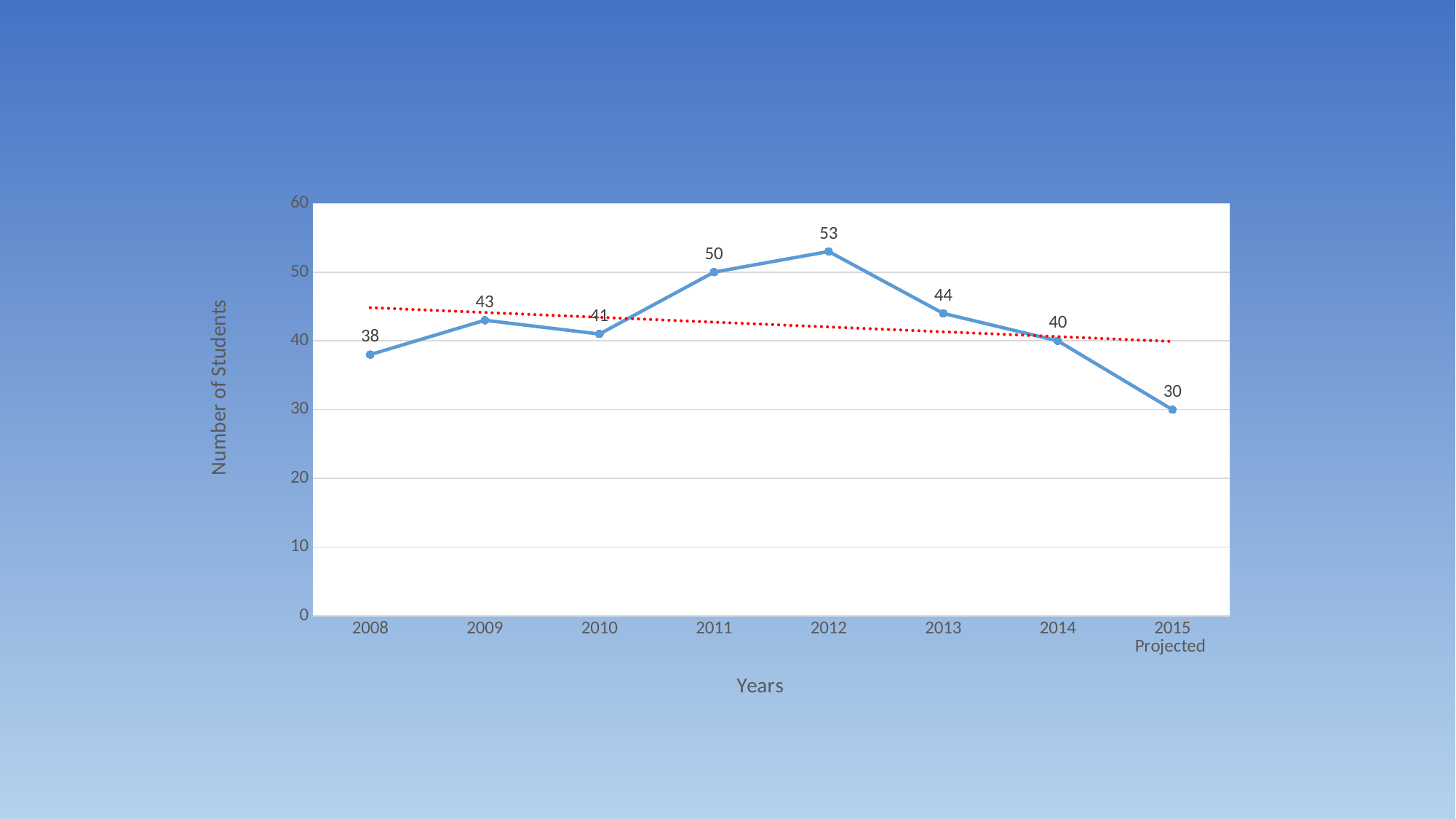
Does the number of students rise or fall from 2012 to 2015 Projected? Fall What is the difference in the number of students between 2012 and 2015 Projected? 23 What is the difference in the number of students between 2011 and 2010? 9 What is the label of the y axis? Number of Students What is the number of students in 2008? 38 Which year has the highest number of students? 2012 What is the number of students in 2012? 53 How many years are plotted on the x axis? 8 What is the projected number of students for 2015? 30 Which year has more students, 2009 or 2013? 2013 Which year has the lowest number of students? 2015 Projected What kind of chart is shown on the slide? Line chart